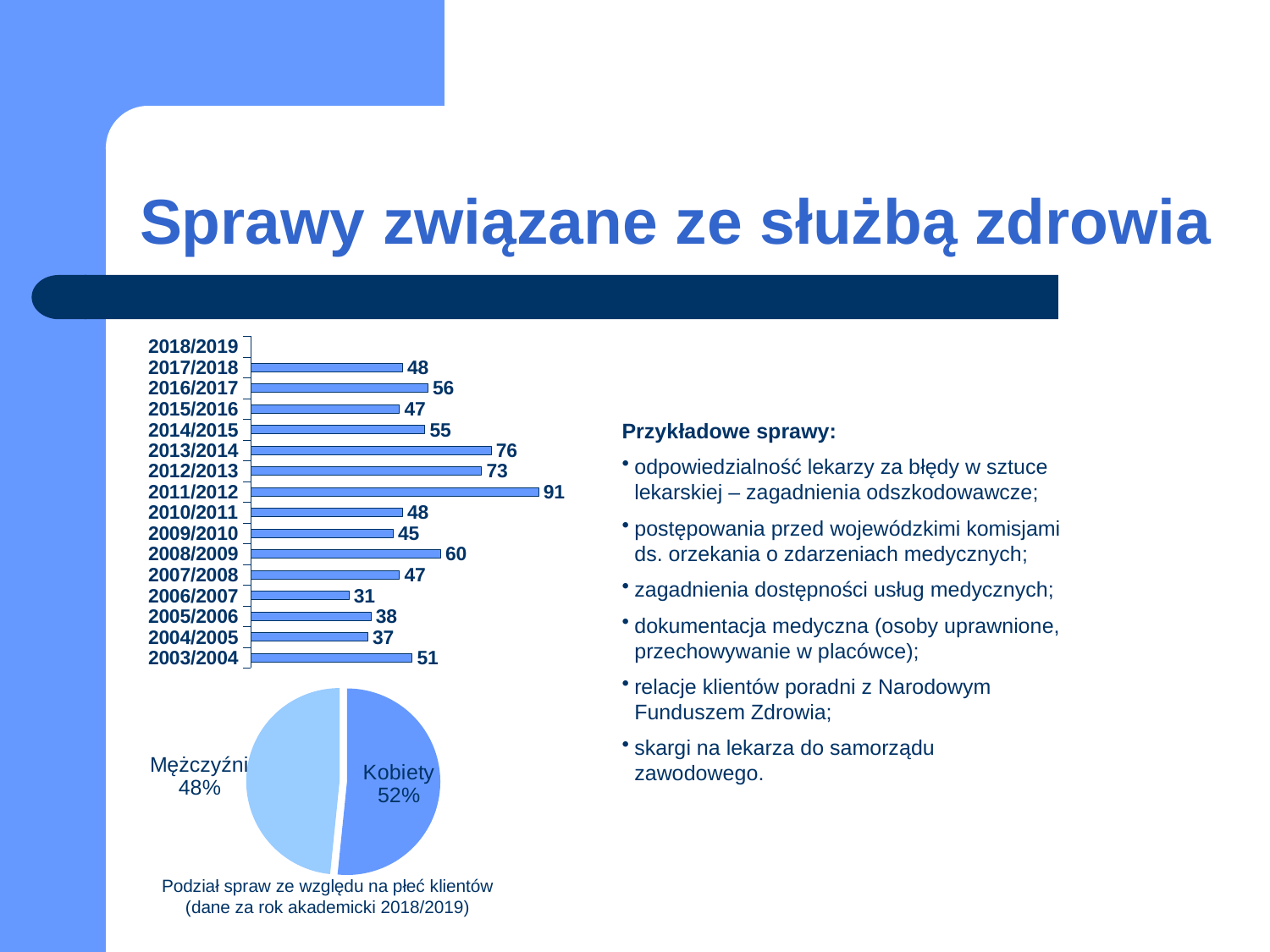
In the bar chart, which is larger: the value for 2008/2009 or the value for 2014/2015? 2008/2009 What kind of chart is the upper chart on the slide? bar chart In the bar chart, what is the difference between the values for 2013/2014 and 2012/2013? 3 In the bar chart, which academic year has the lowest value among the labelled bars? 2006/2007 In the bar chart, how many academic years are listed on the axis? 16 In the pie chart, which slice is larger: Kobiety or Mężczyźni? Kobiety In the bar chart, which academic year has the highest value? 2011/2012 What is the caption below the pie chart? Podział spraw ze względu na płeć klientów (dane za rok akademicki 2018/2019) In the bar chart, what is the value for 2006/2007? 31 In the bar chart, what is the value for 2003/2004? 51 In the pie chart, what share is labelled Kobiety? 52% In the bar chart, what is the value for 2011/2012? 91